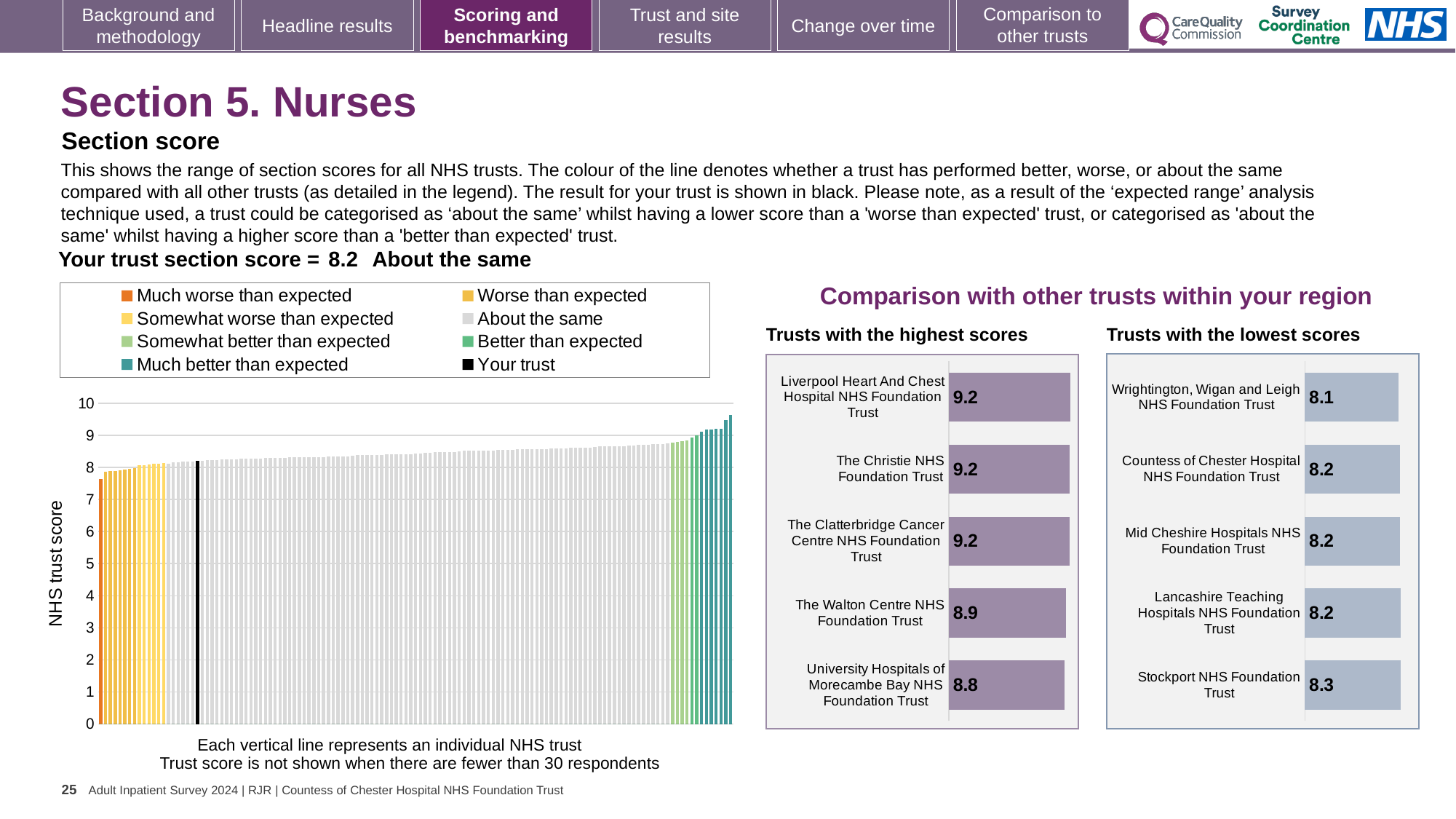
What kind of chart is the main chart on the left showing NHS trust scores? Bar chart In the 'Trusts with the lowest scores' chart, what is the score for Stockport NHS Foundation Trust? 8.3 In the 'Trusts with the highest scores' chart, what is the score for The Walton Centre NHS Foundation Trust? 8.9 In the 'Trusts with the highest scores' chart, what is the difference between the score for Liverpool Heart And Chest Hospital NHS Foundation Trust and the score for University Hospitals of Morecambe Bay NHS Foundation Trust? 0.4 How many entries does the legend of the main NHS trust score chart on the left list? 8 In the 'Trusts with the highest scores' chart, which trust has the lowest score? University Hospitals of Morecambe Bay NHS Foundation Trust In the 'Trusts with the lowest scores' chart, which has the larger score: Stockport NHS Foundation Trust or Wrightington, Wigan and Leigh NHS Foundation Trust? Stockport NHS Foundation Trust How many trusts are shown in the 'Trusts with the highest scores' chart? 5 In the 'Trusts with the lowest scores' chart, which trust has the highest score? Stockport NHS Foundation Trust In the main chart on the left, do the NHS trust scores rise or fall from left to right? Rise In the 'Trusts with the lowest scores' chart, what is the score for Wrightington, Wigan and Leigh NHS Foundation Trust? 8.1 In the 'Trusts with the highest scores' chart, what is the score for University Hospitals of Morecambe Bay NHS Foundation Trust? 8.8